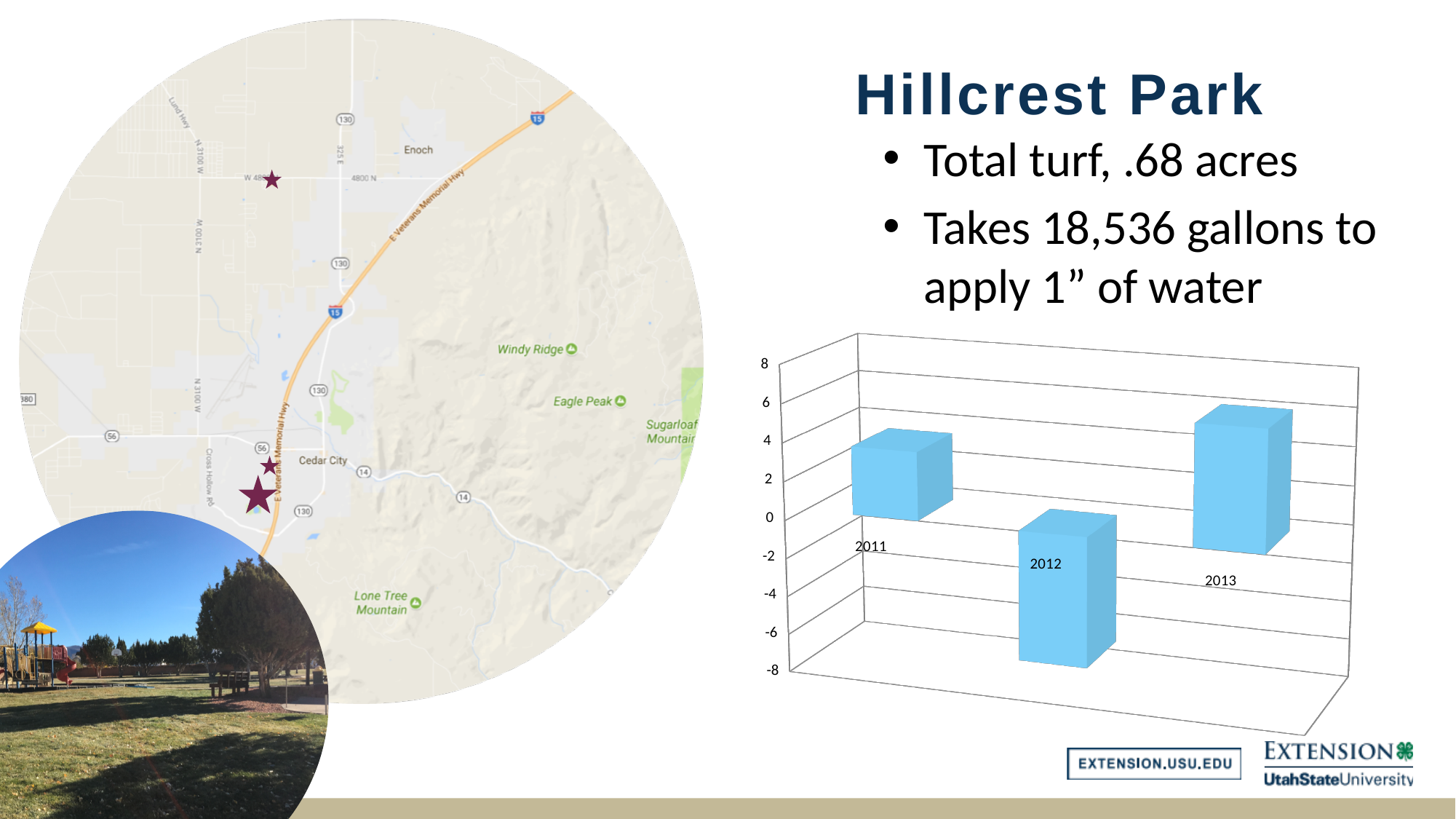
Which year has the larger value, 2011 or 2013? 2013 Does the value rise or fall from 2011 to 2012? fall Is the value for 2013 greater or less than 2? greater Which year has the larger value, 2011 or 2012? 2011 What are the lowest and highest values shown on the chart's vertical axis? -8 and 8 How many years are plotted in the chart? 3 Which year has the lowest value in the chart? 2012 Which year has the highest value in the chart? 2013 What kind of chart is shown on the slide? bar chart Is the value for 2011 greater or less than 0? greater Is the value for 2012 greater or less than 0? less Does the value rise or fall from 2012 to 2013? rise